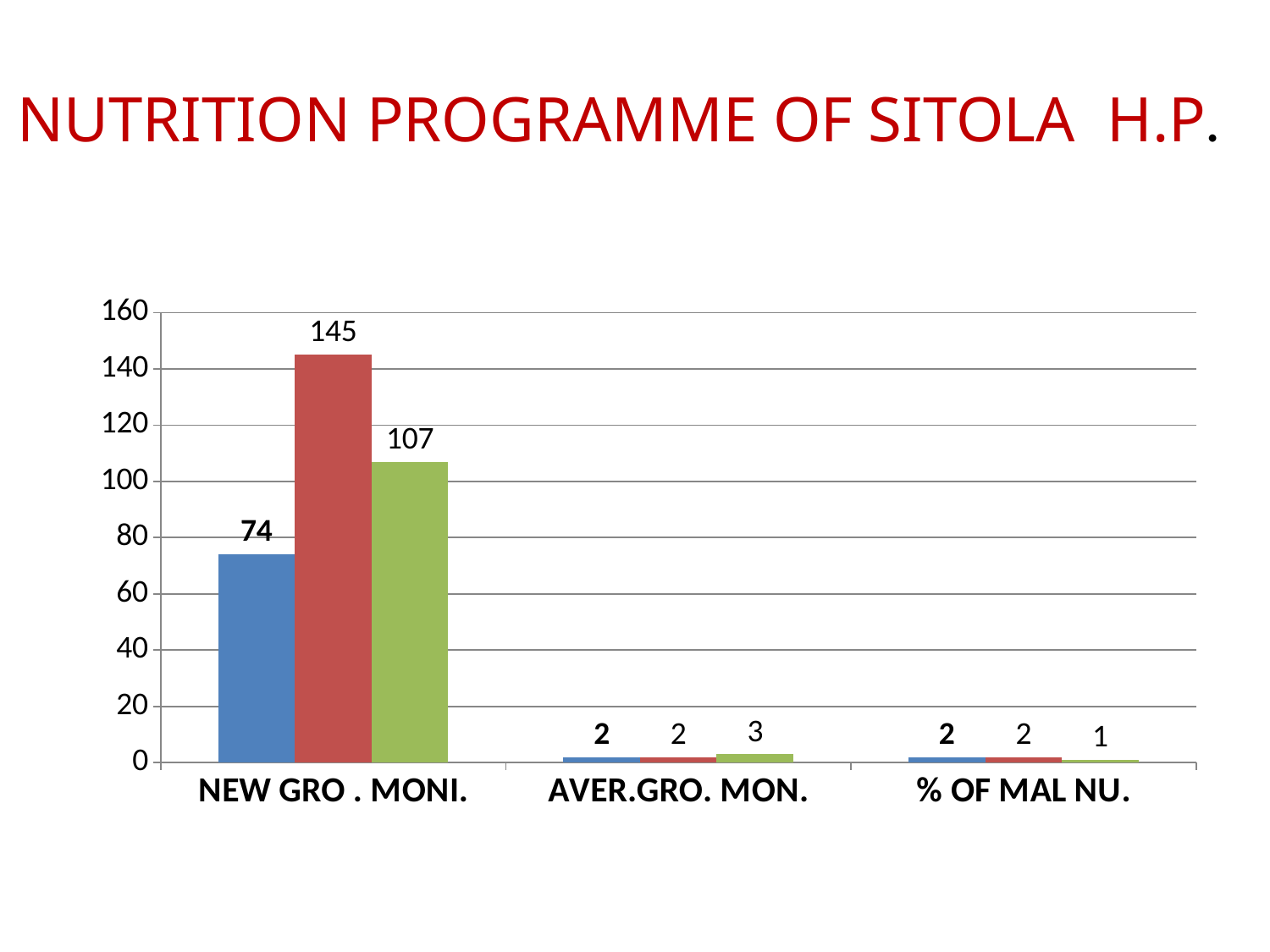
What is the difference between the red bar and the blue bar for NEW GRO . MONI.? 71 What is the difference between the red bar and the green bar for NEW GRO . MONI.? 38 For NEW GRO . MONI., which is larger, the blue bar or the green bar? the green bar What type of chart is shown on the slide? bar chart What is the value of the green bar for % OF MAL NU.? 1 What is the value of the green bar for NEW GRO . MONI.? 107 What is the value of the blue bar for NEW GRO . MONI.? 74 What is the title of the slide containing the chart? NUTRITION PROGRAMME OF SITOLA H.P. What is the value of the green bar for AVER.GRO. MON.? 3 Which category has the highest bar in the chart? NEW GRO . MONI. How many categories are shown on the x axis? 3 What is the value of the red bar for NEW GRO . MONI.? 145